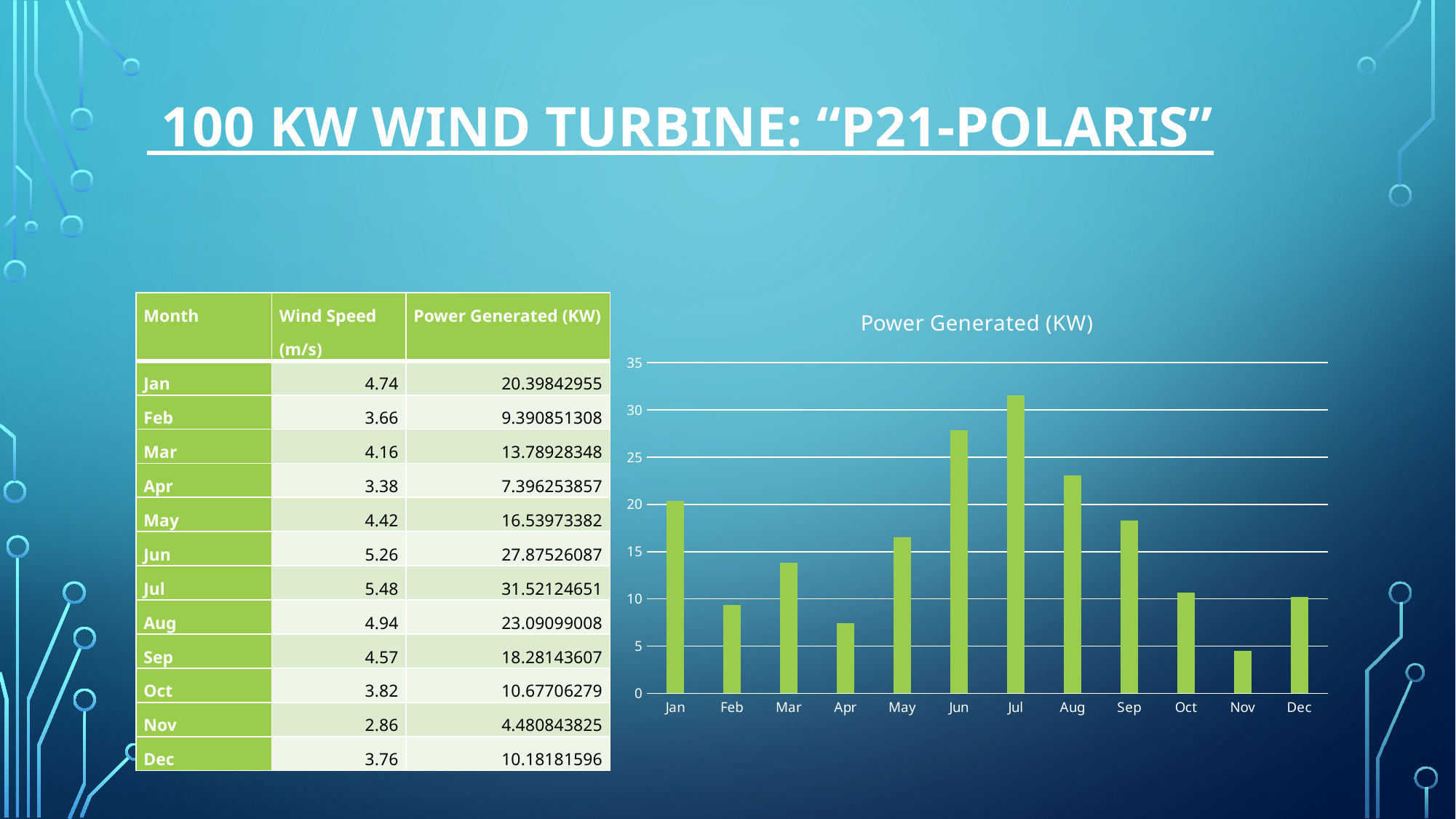
Which has the larger bar, Mar or May? May Is the value for Apr greater or less than 10? less What is the title of the chart? Power Generated (KW) Which month has the highest bar in the chart? Jul Which month has the lowest bar in the chart? Nov Which has the larger bar, Jun or Aug? Jun Is the value for Jul greater or less than 30? greater Do the bars rise or fall from Jul through Nov? fall Is the value for Nov greater or less than 5? less What kind of chart is shown on the slide? bar chart How many months are plotted on the x axis of the chart? 12